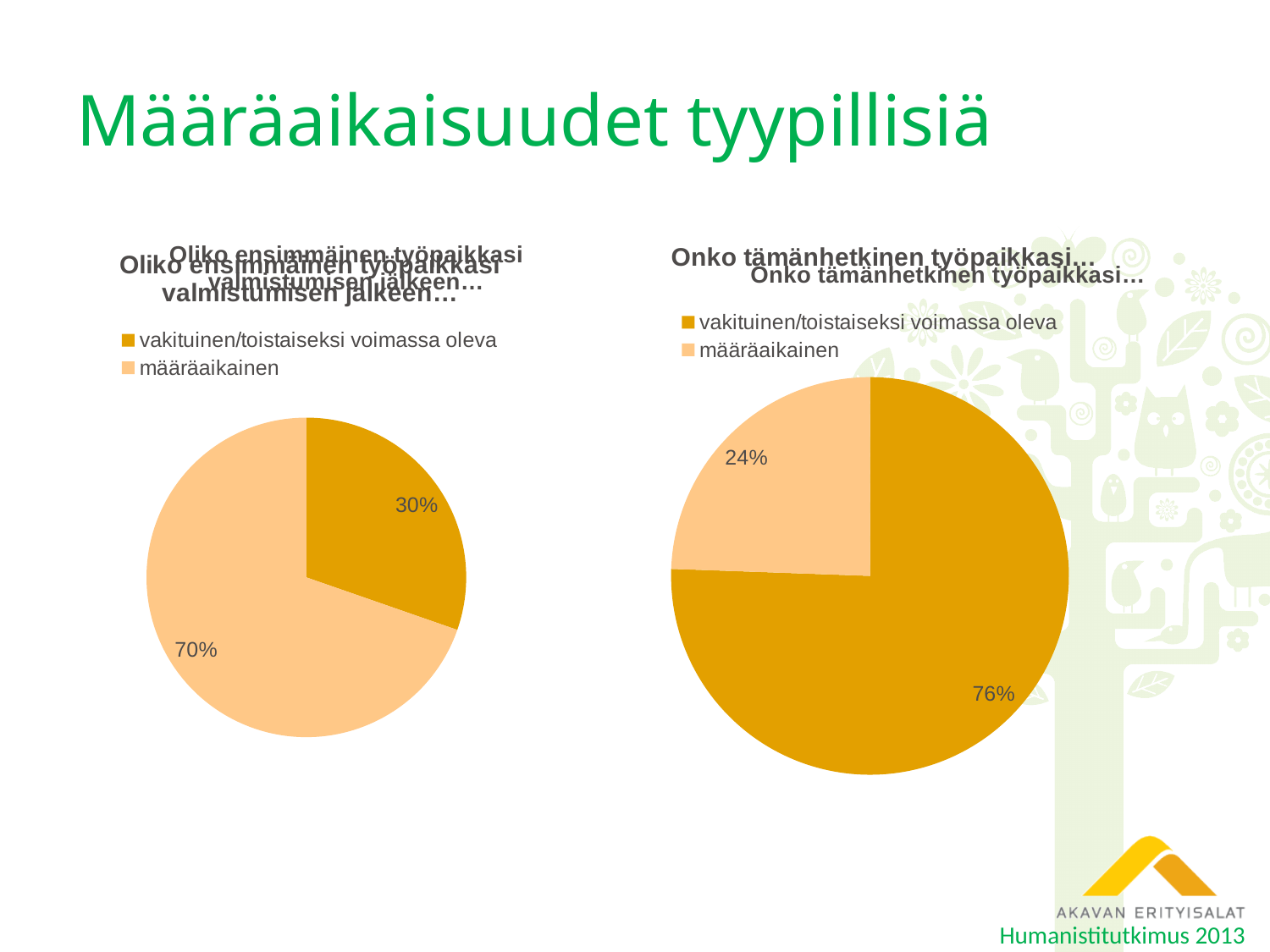
In the left chart (Oliko ensimmäinen työpaikkasi valmistumisen jälkeen…), what share is määräaikainen? 70% How many categories does the right chart (Onko tämänhetkinen työpaikkasi…) show? 2 Which chart shows a larger share for vakituinen/toistaiseksi voimassa oleva, the left chart or the right chart? the right chart In the left chart (Oliko ensimmäinen työpaikkasi valmistumisen jälkeen…), what is the difference between the määräaikainen and vakituinen shares? 40 percentage points What type of chart is the left chart (Oliko ensimmäinen työpaikkasi valmistumisen jälkeen…)? pie chart In the right chart (Onko tämänhetkinen työpaikkasi…), what share is vakituinen/toistaiseksi voimassa oleva? 76% How many charts are on the slide? 2 In the right chart (Onko tämänhetkinen työpaikkasi…), which category has the smallest slice? määräaikainen In the right chart (Onko tämänhetkinen työpaikkasi…), what is the difference between the vakituinen and määräaikainen shares? 52 percentage points In the right chart (Onko tämänhetkinen työpaikkasi…), what share is määräaikainen? 24% In the left chart (Oliko ensimmäinen työpaikkasi valmistumisen jälkeen…), which category has the largest slice? määräaikainen In the left chart (Oliko ensimmäinen työpaikkasi valmistumisen jälkeen…), what share is vakituinen/toistaiseksi voimassa oleva? 30%